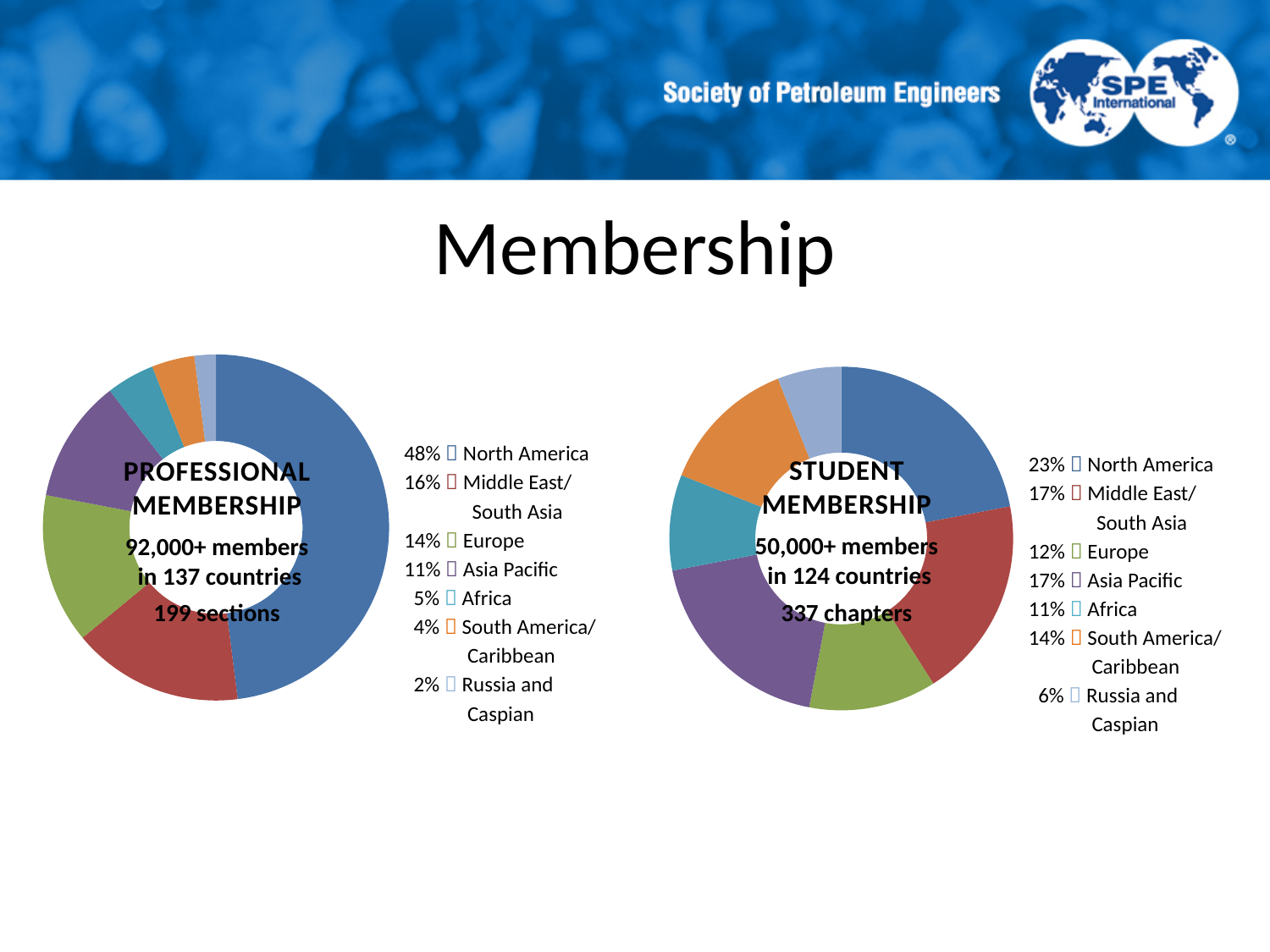
Which is larger in the Student Membership chart: the share for South America/Caribbean or the share for Europe? South America/Caribbean In the Professional Membership chart, which region has the largest share? North America In the Professional Membership chart, what share of members is from North America? 48% In the Student Membership chart, what share of members is from Africa? 11% What type of chart is used for the Professional Membership breakdown? Pie chart (donut) How many regions are shown in the Student Membership chart? 7 In the Professional Membership chart, which region has the smallest share? Russia and Caspian In the Student Membership chart, which region has the smallest share? Russia and Caspian In the Professional Membership chart, what is the difference between the Middle East/South Asia share and the Africa share? 11% In the Student Membership chart, what share of members is from Asia Pacific? 17% In the Student Membership chart, what is the difference between the North America share and the Europe share? 11% According to the Professional Membership chart, how many sections are there? 199 sections